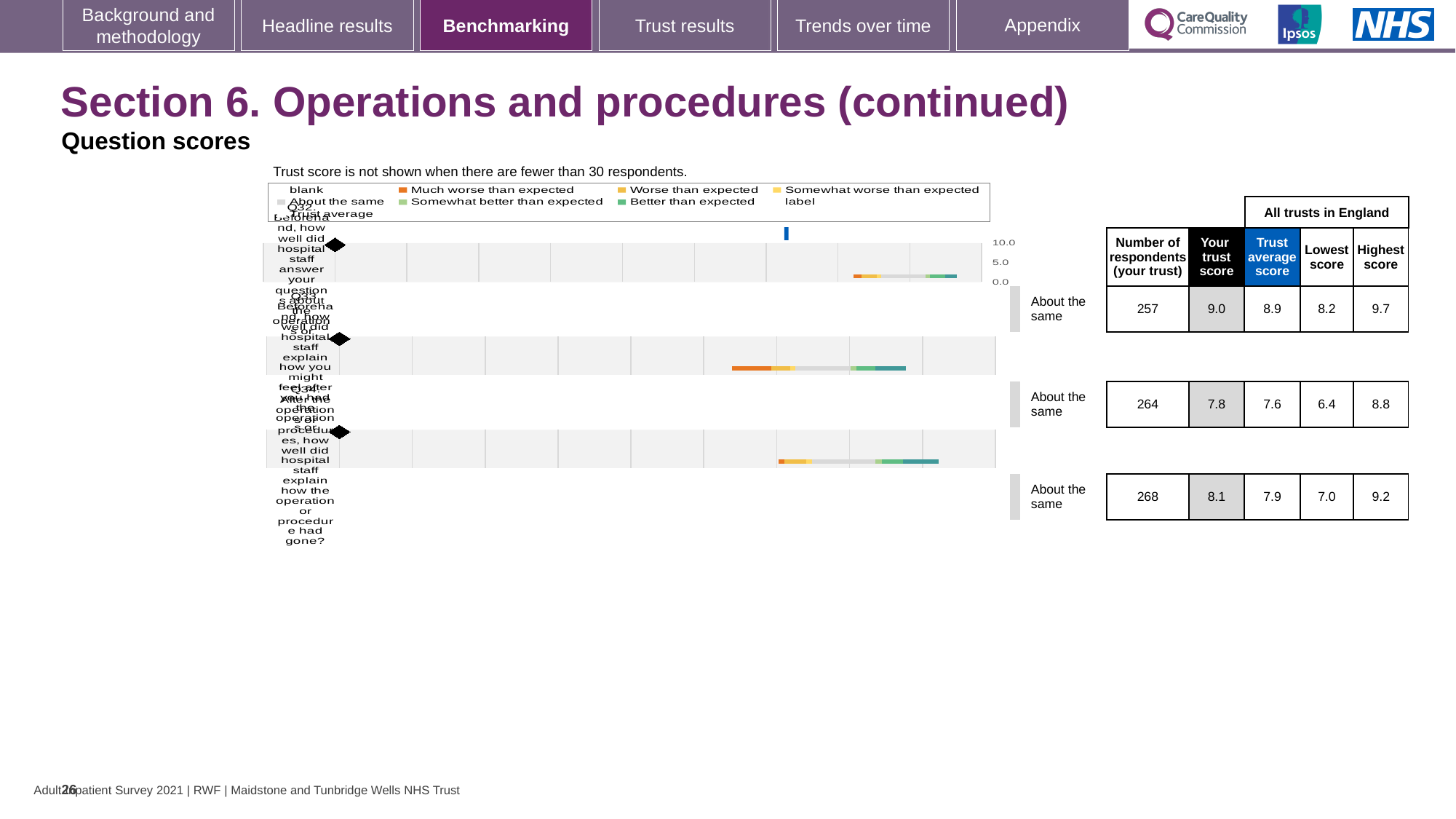
For the second question row, which is larger: 'Your trust score' or the 'Trust average score'? Your trust score For the first question row, what is the difference between 'Your trust score' and the 'Trust average score'? 0.1 Which question row has the lowest 'Lowest score' across all trusts in England? The second row (6.4) Which question row has the highest 'Your trust score'? The first row (9.0) For the third question row, what is the difference between the 'Highest score' and the 'Lowest score'? 2.2 In the table beside the chart, how many respondents are shown for the first question row? 257 What kind of chart is used to show the question scores? Bar chart In the table beside the chart, what is the 'Highest score' for the third question row? 9.2 In the table beside the chart, what is 'Your trust score' for the second question row? 7.8 How many question rows are plotted in the chart? 3 What benchmark category is shown for all three question rows? About the same In the table beside the chart, what is the 'Lowest score' for the first question row? 8.2